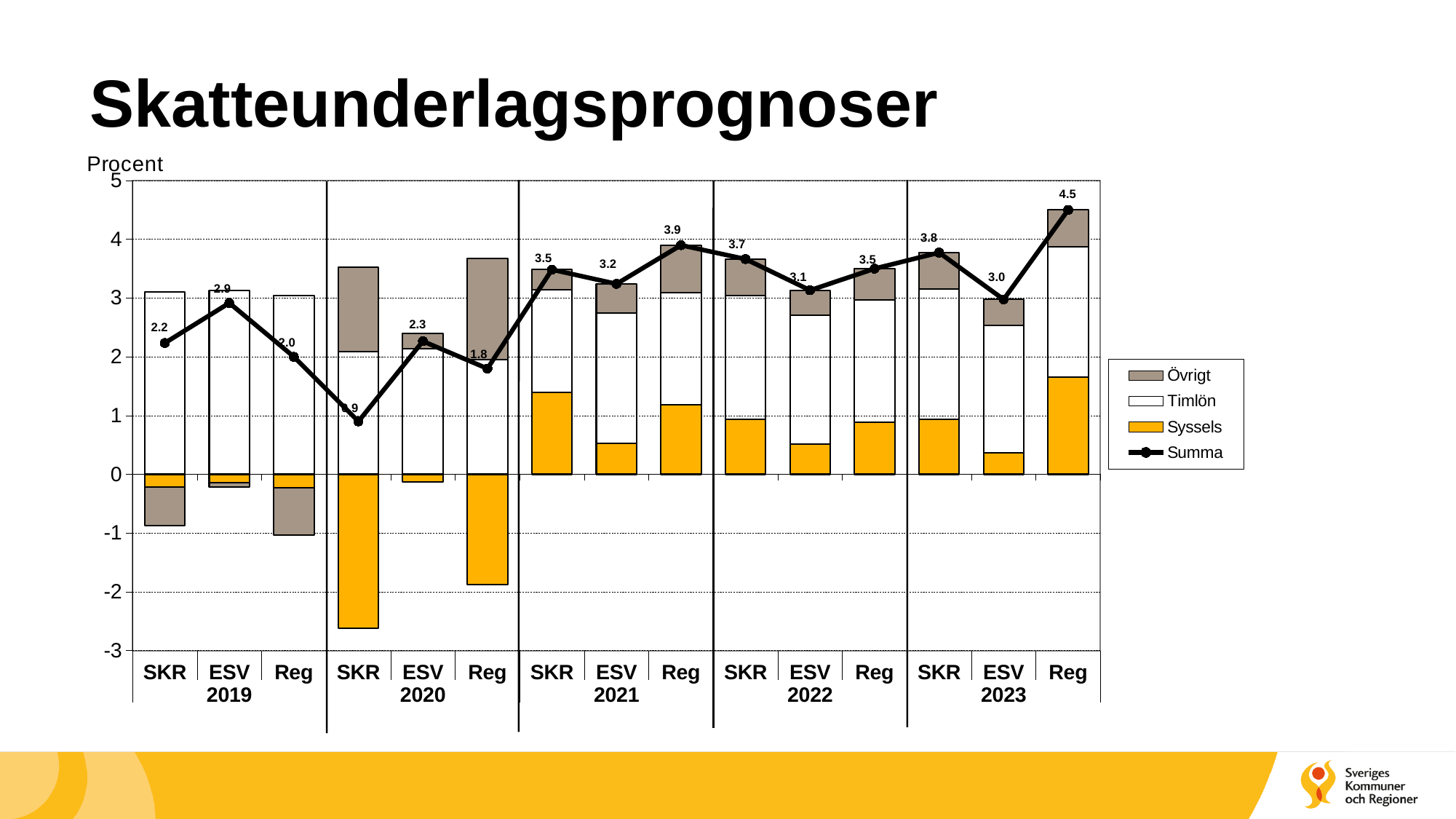
What kind of chart is shown on the slide? Stacked bar chart with a line Which category has the highest Summa value? Reg 2023 What is the Summa value for Reg in 2023? 4.5 What is the difference between the Summa value for Reg in 2023 and SKR in 2019? 2.3 What is the title of the slide? Skatteunderlagsprognoser Is the Syssels value for SKR in 2020 greater or less than -2? less How many series does the legend list? 4 What is the Summa value for SKR in 2021? 3.5 How many categories are shown on the x axis? 15 Which category has the lowest Summa value? SKR 2020 What is the Summa value for ESV in 2019? 2.9 Which has a larger Summa value, Reg in 2021 or ESV in 2021? Reg 2021